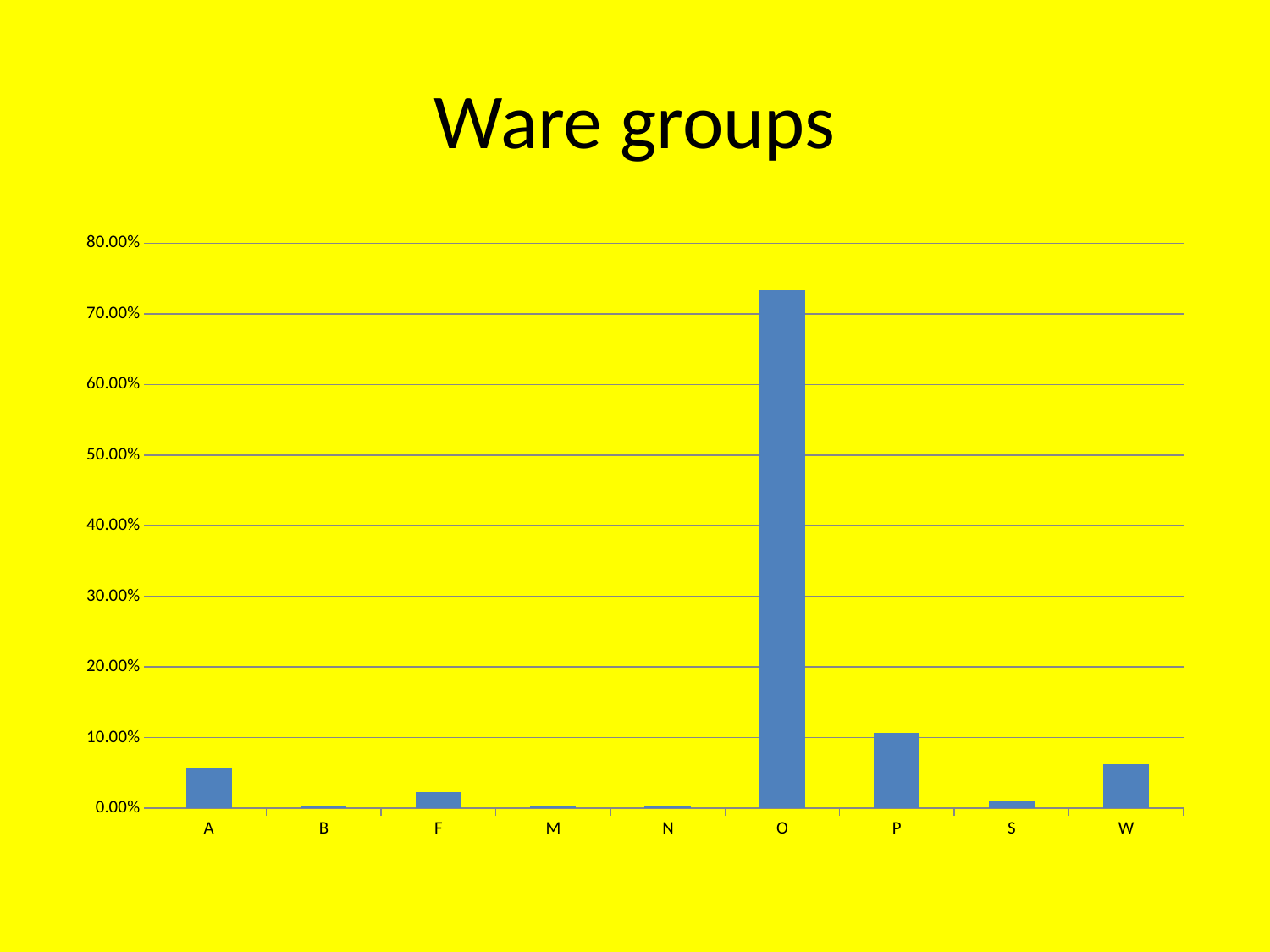
What colour are the bars in the chart? blue Which has the larger value, F or W? W How many categories are shown on the x axis of the chart? 9 Which has the larger value, O or P? O Which has the larger value, P or A? P What is the title of the chart? Ware groups Which category has the highest value in the chart? O Is the value for A greater or less than 10.00%? less Is the value for P greater or less than 20.00%? less What kind of chart is shown on the slide? bar chart Is the value for W greater or less than 10.00%? less